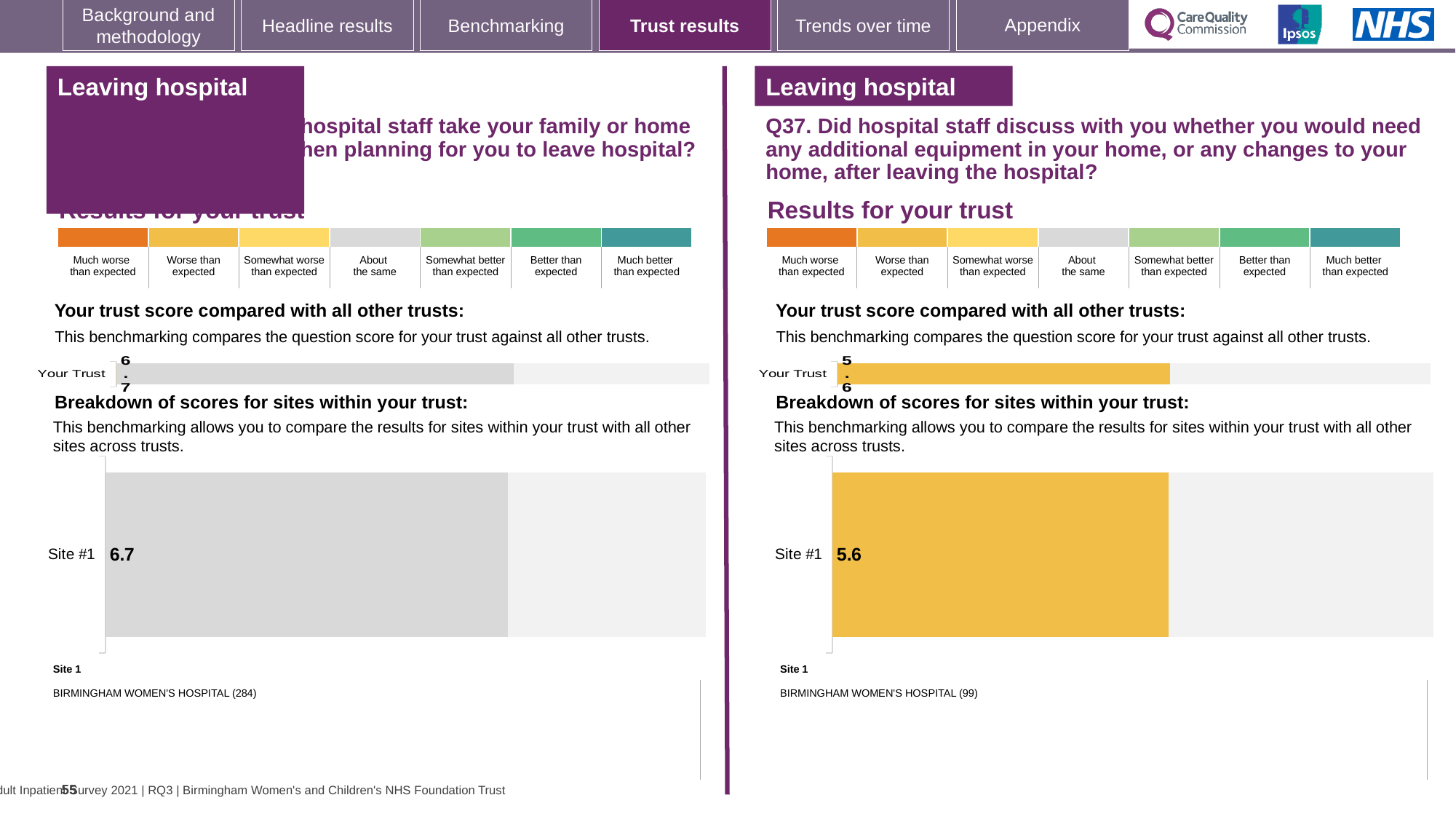
What colour is the Site #1 bar on the right-hand chart (Q37)? Yellow Which is larger: the Site #1 score on the left-hand chart or the Site #1 score on the right-hand chart (Q37)? Left-hand chart (6.7) On the left-hand chart, what is the score shown for Your Trust? 6.7 On the right-hand chart (Q37), what is the score shown for Your Trust? 5.6 What colour is the Site #1 bar on the left-hand chart? Grey Is the Your Trust score on the right-hand chart (Q37) greater or less than 6? less How many sites are shown in the breakdown of scores chart on the right-hand side (Q37)? 1 What is the difference between the Site #1 score on the left-hand chart and the Site #1 score on the right-hand chart (Q37)? 1.1 On the right-hand chart (Q37), what is the score shown for Site #1? 5.6 What kind of chart is used to show the Site #1 score on the right-hand side (Q37)? Bar chart On the left-hand chart, what is the score shown for Site #1? 6.7